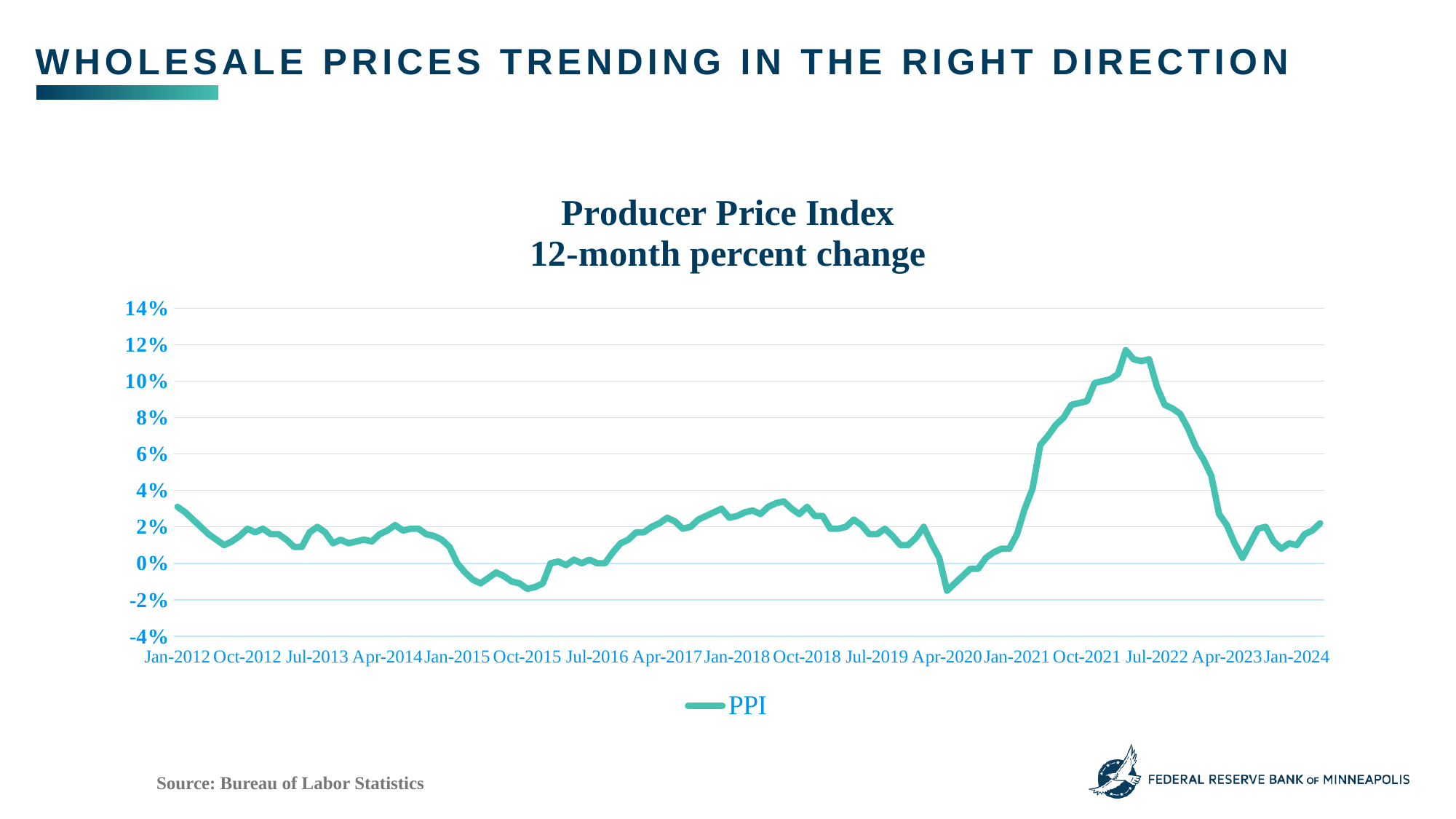
Which is larger, the PPI value at Oct-2021 or at Apr-2023? Oct-2021 Is the PPI value at Apr-2020 greater or less than 0%? less Is the PPI value at Oct-2015 greater or less than 0%? less What kind of chart is shown on the slide? Line chart How many series does the legend list? 1 What is the title of the chart? Producer Price Index 12-month percent change Does the PPI line rise or fall between Jul-2022 and Apr-2023? fall Is the PPI value at Oct-2021 greater or less than 6%? greater In which year does the PPI line reach its highest value? 2022 What is the name of the series shown in the legend? PPI